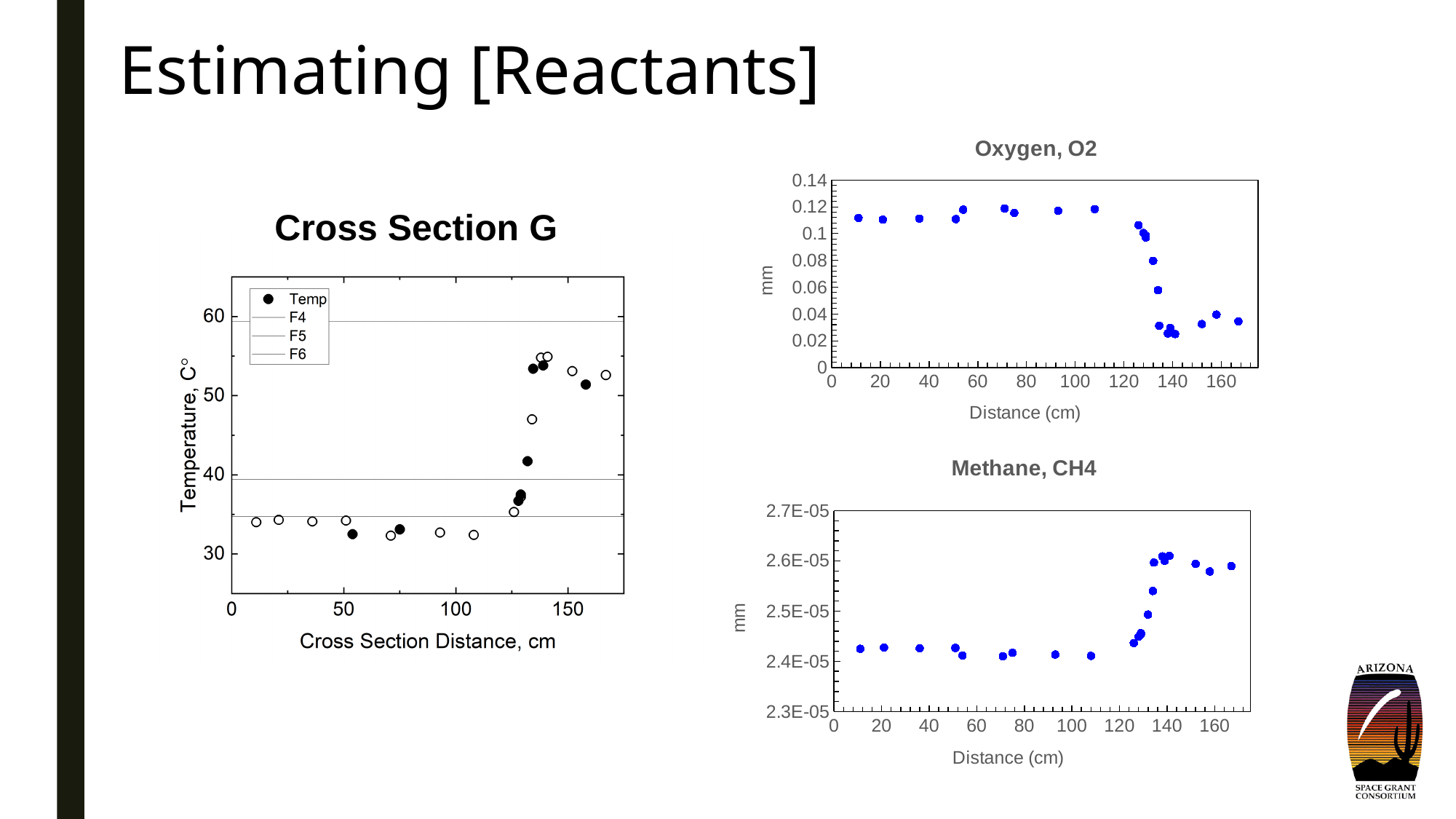
In the "Cross Section G" chart, do the temperature values rise or fall as cross section distance increases? rise In the "Cross Section G" chart, is the temperature at about 150 cm greater or less than 50? greater In the "Oxygen, O2" chart, is the value at about 20 cm greater or less than 0.1? greater What is the x-axis label of the "Oxygen, O2" chart? Distance (cm) In the "Methane, CH4" chart, do the values rise or fall as distance increases? rise How many series does the legend of the "Cross Section G" chart list? 4 In the "Methane, CH4" chart, is the value at about 20 cm greater or less than 2.5E-05? less What kind of chart is the "Cross Section G" chart? scatter chart In the "Oxygen, O2" chart, do the values rise or fall as distance increases? fall